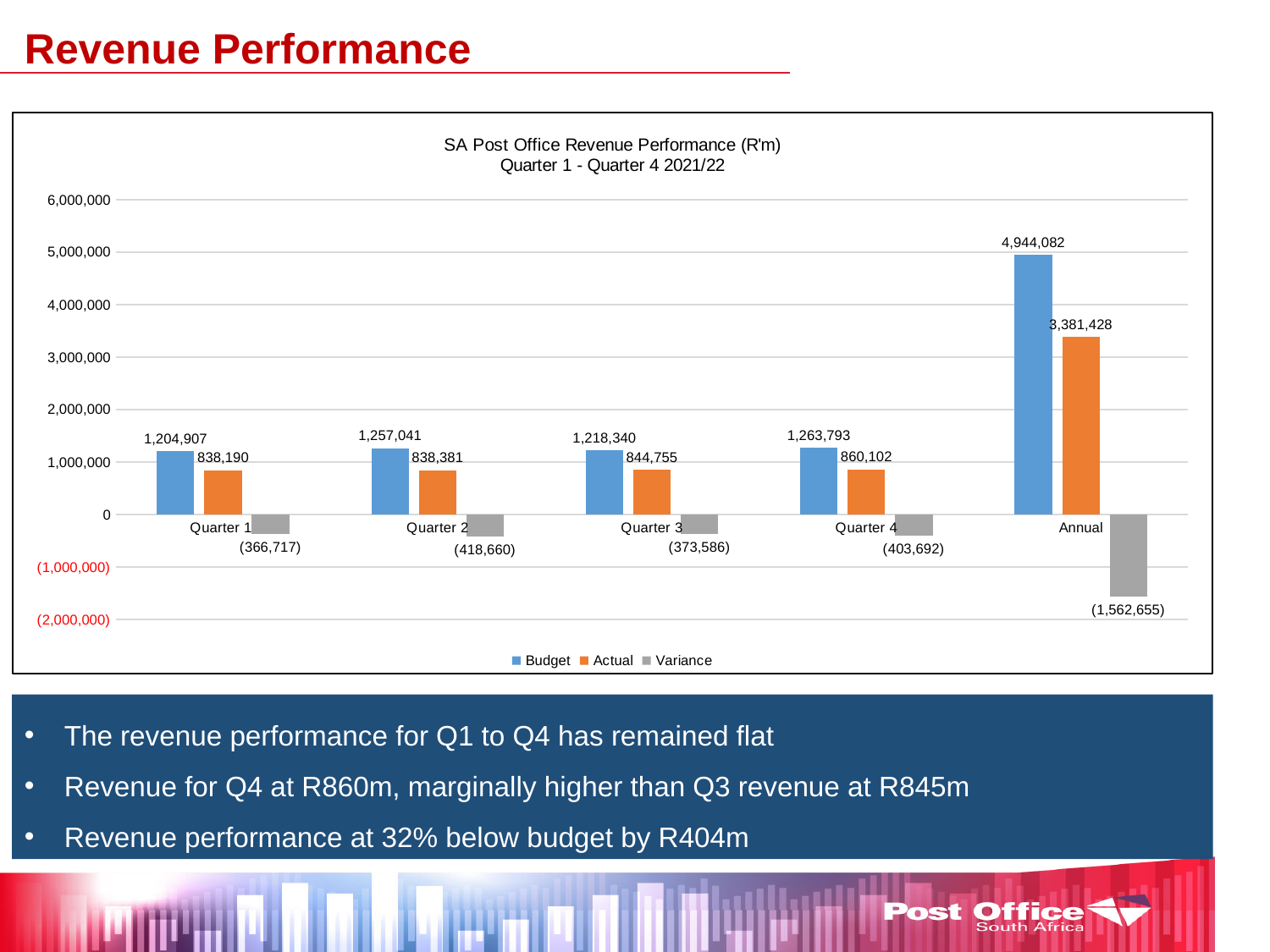
Do the Actual values rise or fall from Quarter 1 to Quarter 4? Rise How many categories are shown on the x axis? 5 How many series does the legend list? 3 What is the Actual value for Quarter 4? 860,102 What is the difference between the Actual values for Quarter 4 and Quarter 3? 15,347 What kind of chart is shown on the slide? Bar chart What is the Annual Actual value? 3,381,428 Which is larger, the Budget for Quarter 2 or the Budget for Quarter 3? Quarter 2 What is the Budget value for Quarter 1? 1,204,907 What is the Variance value for Quarter 2? (418,660) Which quarter has the highest Actual value? Quarter 4 Which quarter has the lowest Budget value? Quarter 1